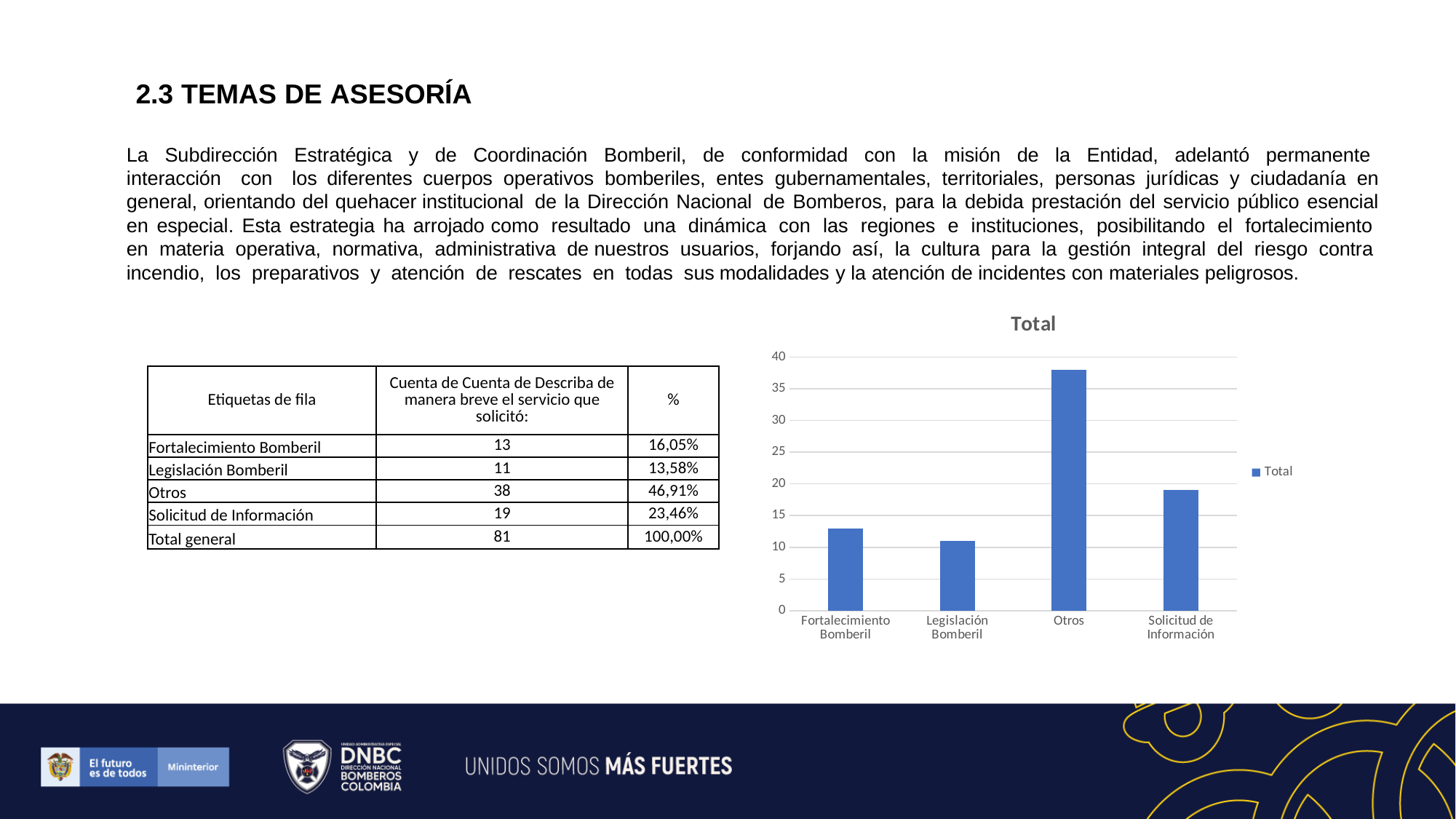
How many series does the chart legend list? 1 Which category has the lowest bar in the chart? Legislación Bomberil How many categories are shown on the x axis of the chart? 4 Is the value for Solicitud de Información greater or less than 20? less Which is larger, the bar for Solicitud de Información or the bar for Fortalecimiento Bomberil? Solicitud de Información Which category has the highest bar in the chart? Otros What kind of chart is shown on the slide? bar chart What is the title of the chart? Total According to the table on the slide, what is the count for Otros? 38 Is the value for Otros greater or less than 35? greater According to the table on the slide, what is the difference between the counts for Otros and Legislación Bomberil? 27 Is the value for Fortalecimiento Bomberil greater or less than 10? greater